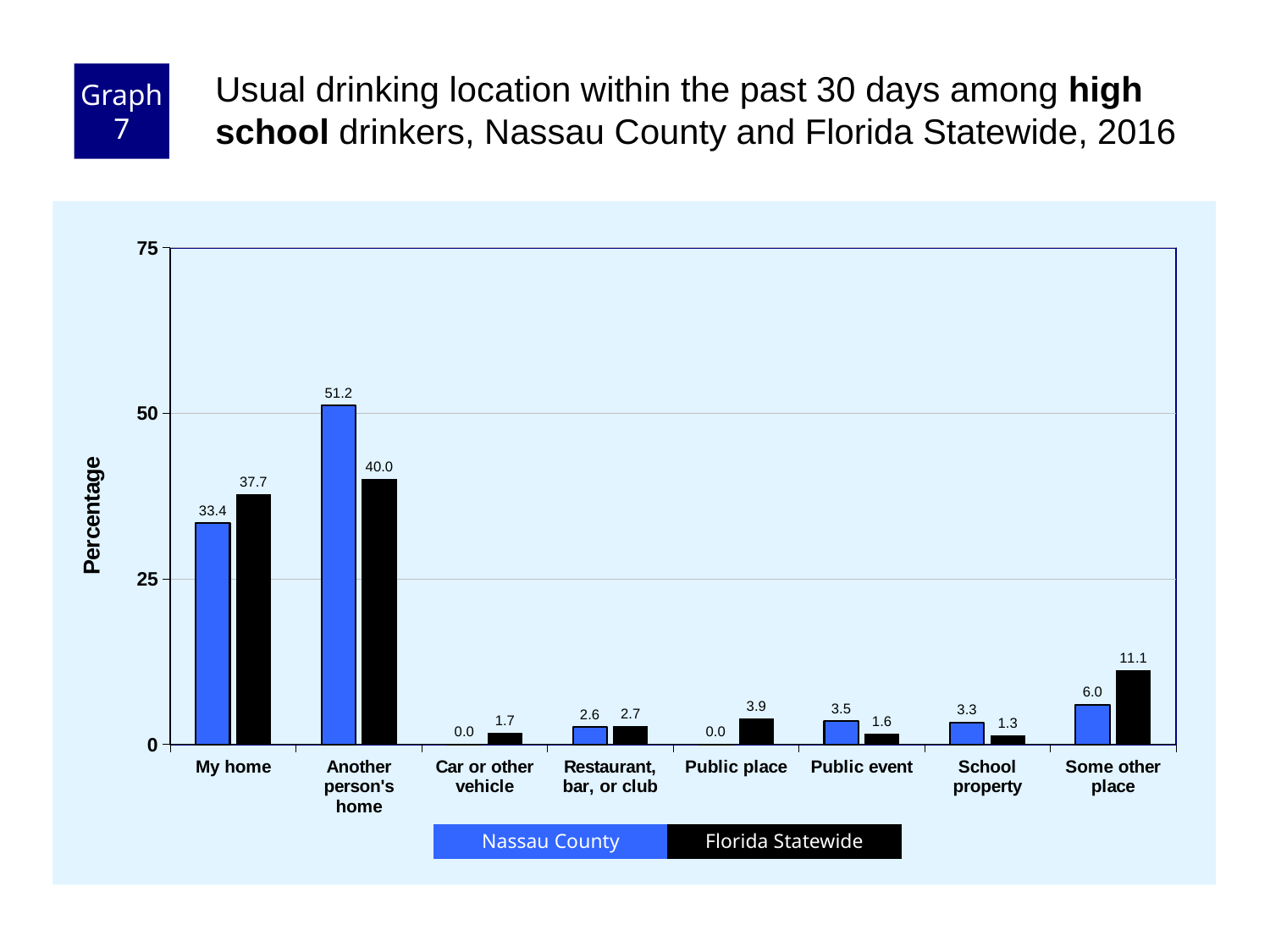
What is the Florida Statewide value for "Some other place"? 11.1 Which category has the highest Nassau County value? Another person's home What is the difference between the Nassau County and Florida Statewide values for "Another person's home"? 11.2 What is the Nassau County value for "Another person's home"? 51.2 Which is larger for "Public event": the Nassau County value or the Florida Statewide value? Nassau County What is the Florida Statewide value for "My home"? 37.7 How many categories are shown on the x axis? 8 Is the Nassau County value for "Another person's home" greater or less than 50? greater Which category has the lowest Florida Statewide value? School property What is the label of the y axis? Percentage How many series does the legend list? 2 What kind of chart is shown on the slide? Bar chart